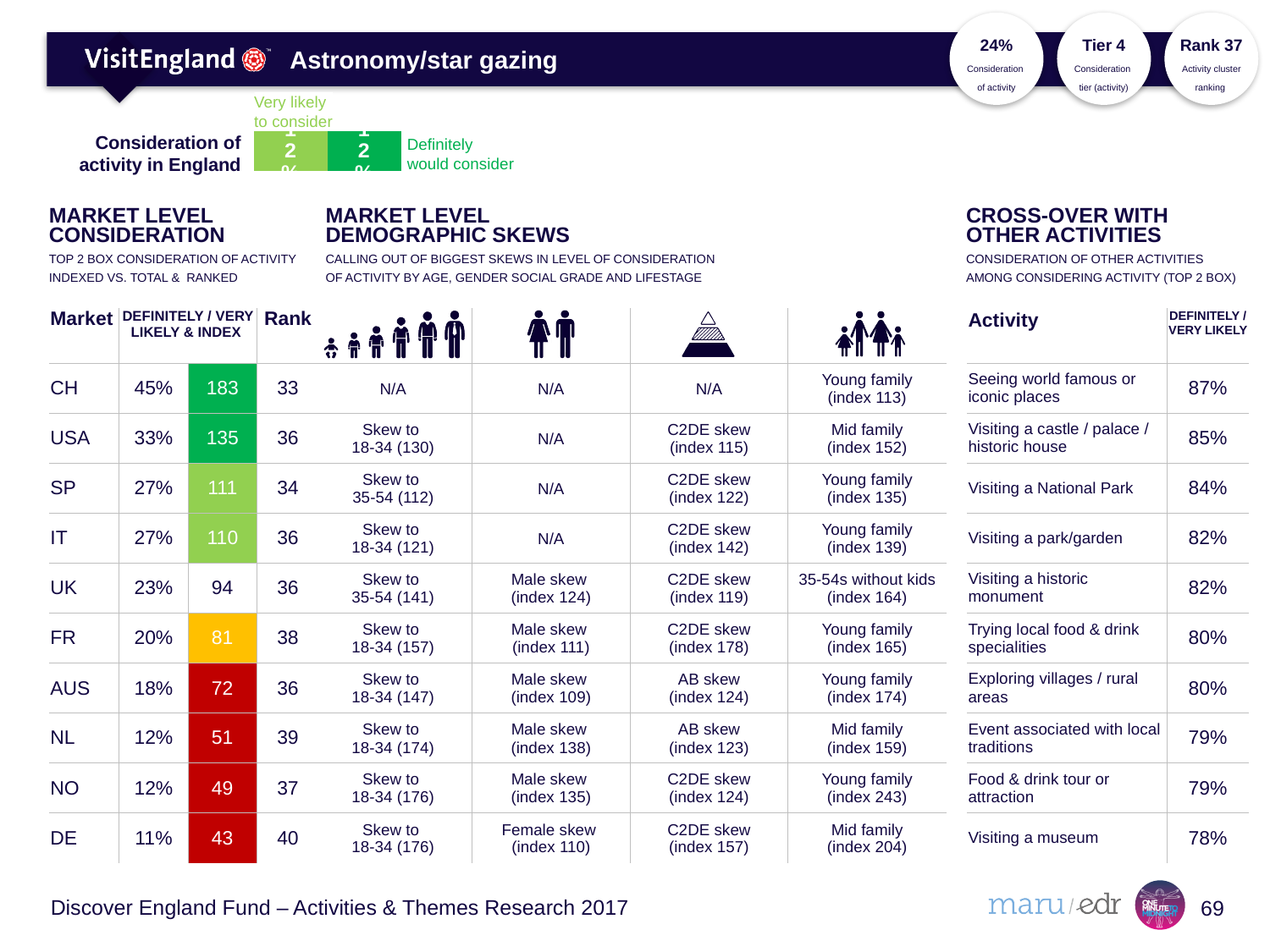
How many bars are plotted in the 'Consideration of activity in England' chart? 1 What is the total of the stacked bar in the 'Consideration of activity in England' chart? 24% What kind of chart is the 'Consideration of activity in England' chart? bar chart How many series does the legend of the 'Consideration of activity in England' chart list? 2 Which legend entry in the 'Consideration of activity in England' chart is shown in the darker green colour? Definitely would consider Which legend entry in the 'Consideration of activity in England' chart is shown in the lighter green colour? Very likely to consider What is the difference between the 'Very likely to consider' and 'Definitely would consider' values in the 'Consideration of activity in England' chart? 0% In the 'Consideration of activity in England' chart, what is the value for 'Definitely would consider'? 12% In the 'Consideration of activity in England' chart, what is the value for 'Very likely to consider'? 12%